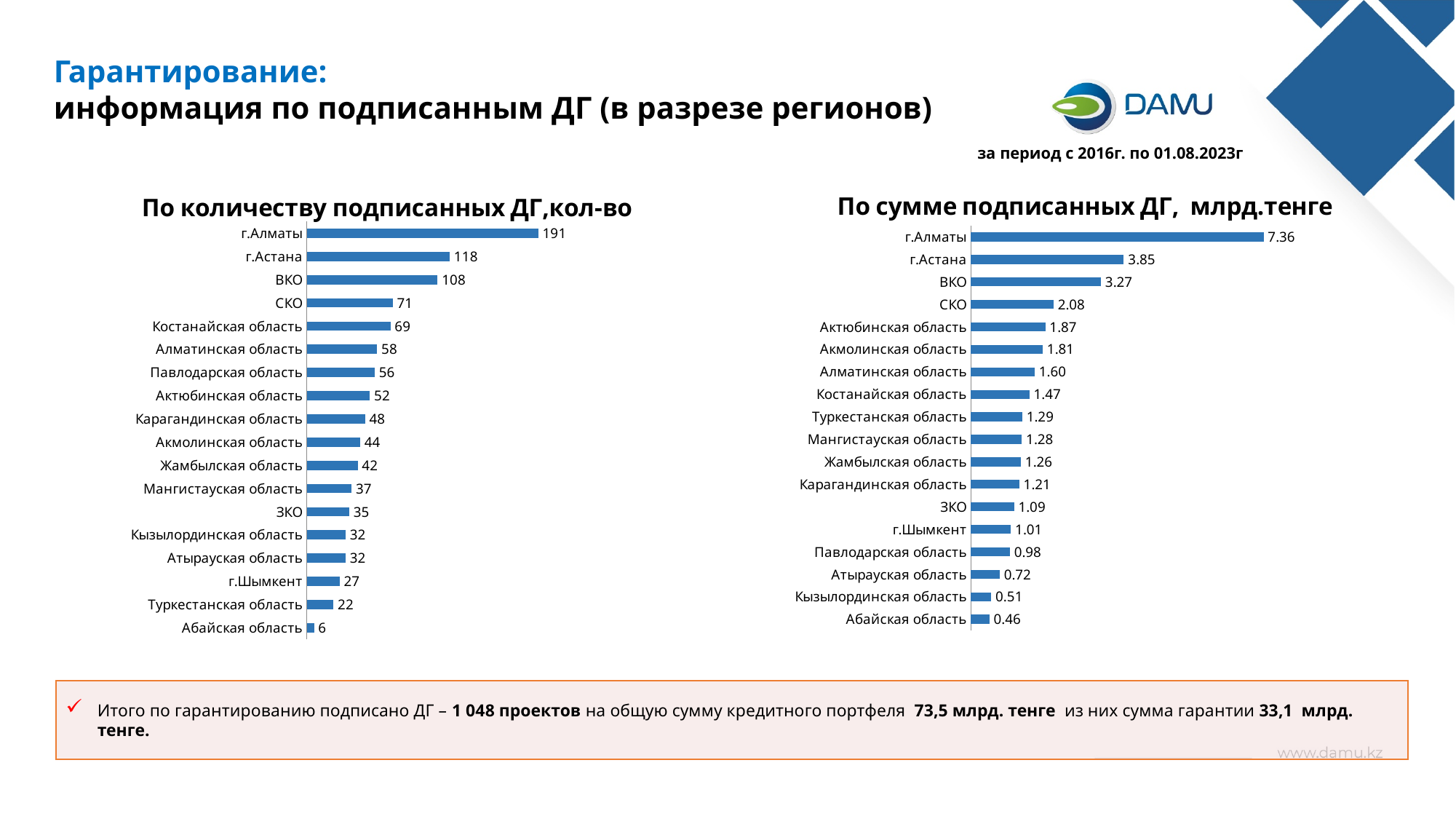
In the chart 'По количеству подписанных ДГ,кол-во', which region has the lowest value? Абайская область In the chart 'По количеству подписанных ДГ,кол-во', what is the difference between г.Алматы and г.Астана? 73 In the chart 'По сумме подписанных ДГ, млрд.тенге', what is the value for г.Шымкент? 1.01 In the chart 'По количеству подписанных ДГ,кол-во', what is the value for ВКО? 108 In the chart 'По сумме подписанных ДГ, млрд.тенге', what is the difference between г.Астана and ВКО? 0.58 In the chart 'По количеству подписанных ДГ,кол-во', which region has the highest value? г.Алматы In the chart 'По количеству подписанных ДГ,кол-во', how many regions are shown? 18 In the chart 'По количеству подписанных ДГ,кол-во', what is the value for Туркестанская область? 22 In the chart 'По сумме подписанных ДГ, млрд.тенге', which is larger: Актюбинская область or Костанайская область? Актюбинская область In the chart 'По сумме подписанных ДГ, млрд.тенге', what is the value for СКО? 2.08 What type of chart is 'По сумме подписанных ДГ, млрд.тенге'? Bar chart In the chart 'По сумме подписанных ДГ, млрд.тенге', which region has the highest value? г.Алматы